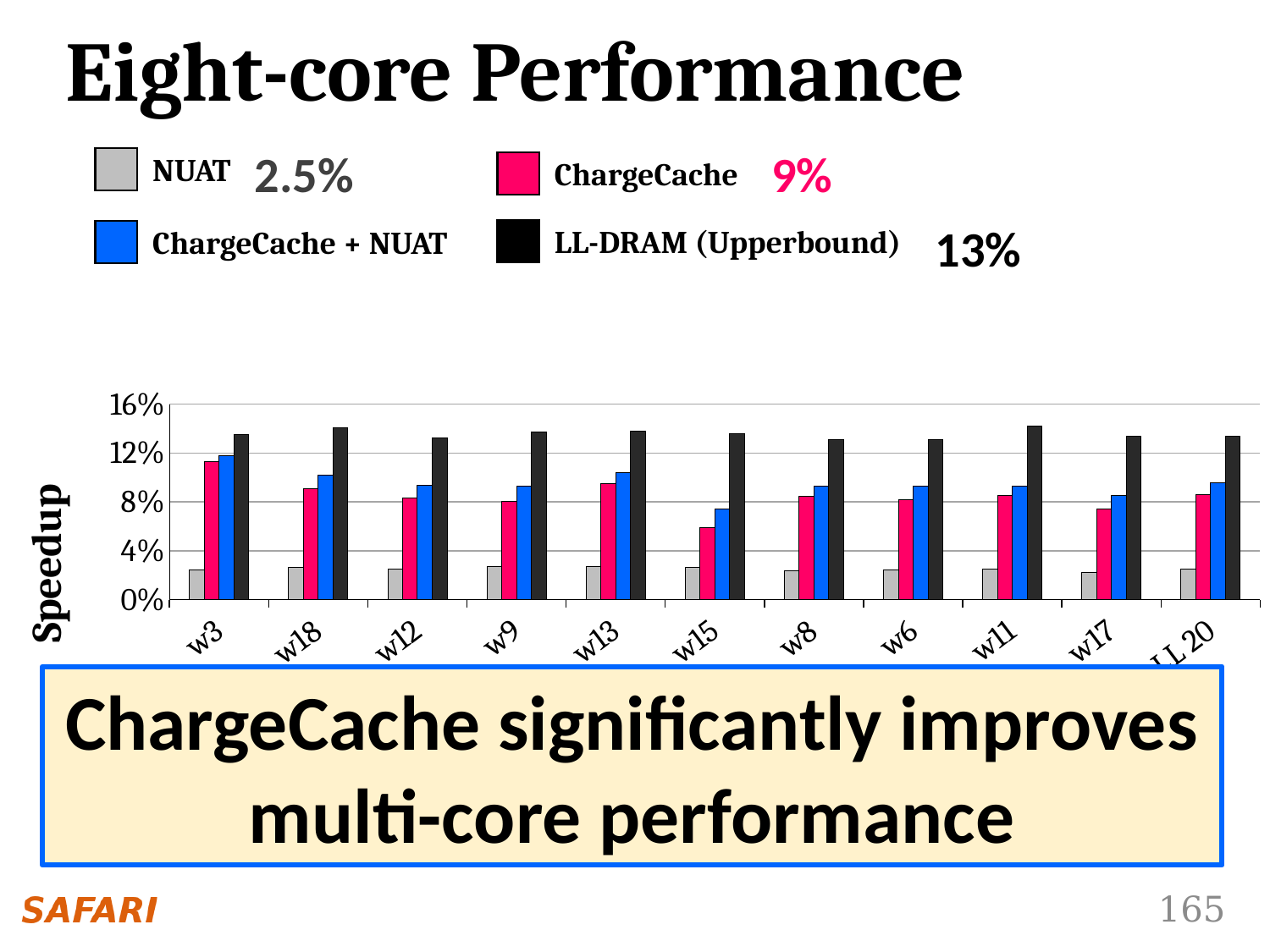
How many series does the chart's legend list? 4 Is the ChargeCache + NUAT speedup for w18 greater or less than 8%? greater What percentage is printed next to ChargeCache in the legend? 9% What is the label of the y axis? Speedup How many groups of bars (workloads) are plotted along the x axis? 11 Is the NUAT speedup for w3 greater or less than 4%? less Is the ChargeCache speedup for w3 greater or less than 8%? greater Which workload has the highest ChargeCache speedup? w3 Which workload has the lowest ChargeCache speedup? w15 What kind of chart is shown on the slide? bar chart